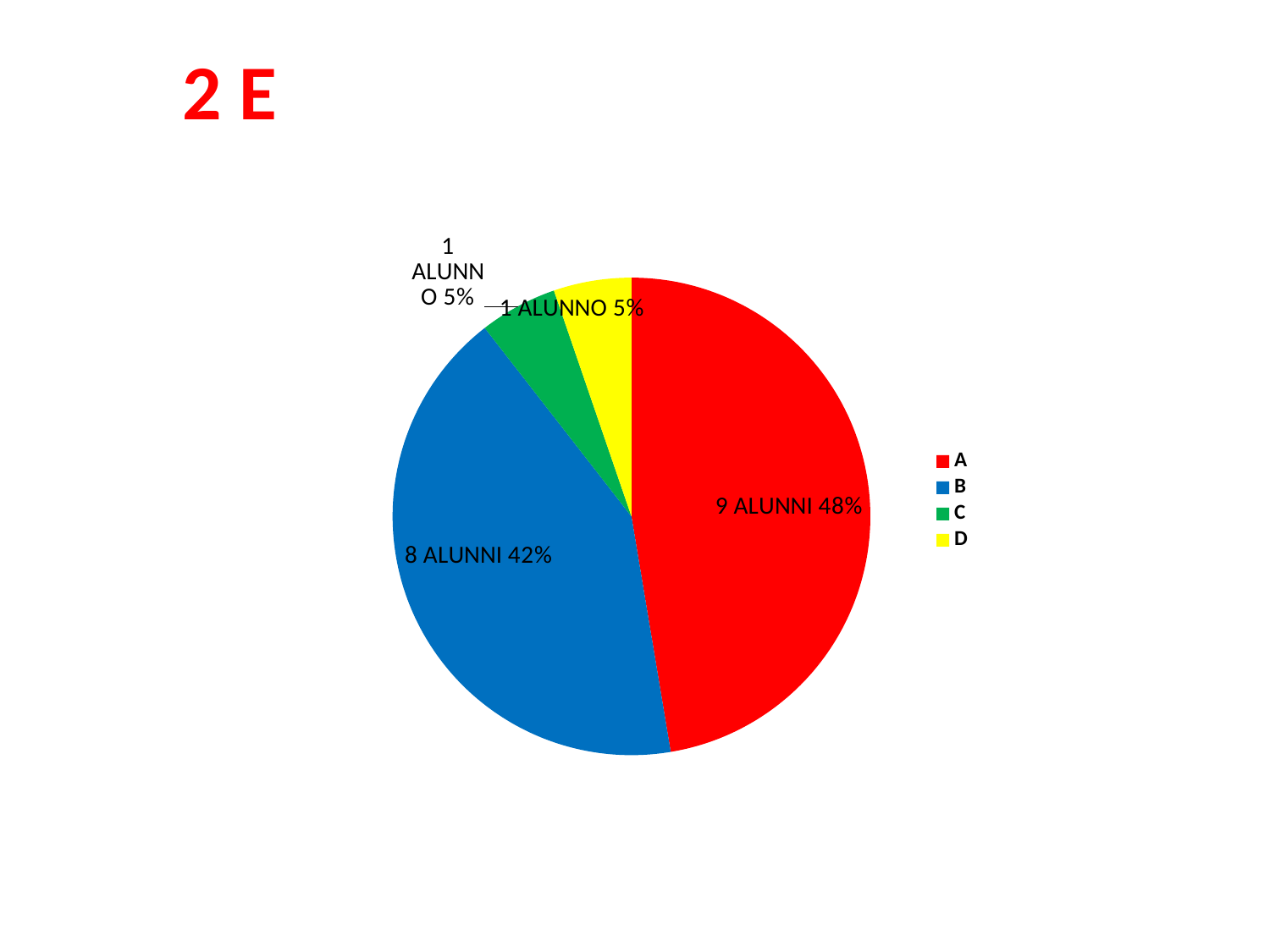
How many alunni are in category A? 9 ALUNNI What percentage share does category A have? 48% How many alunni are in category B? 8 ALUNNI What is the difference in percentage points between category A and category B? 6% What kind of chart is shown on the slide? pie chart What percentage share does category D (yellow) have? 5% How many categories does the legend list? 4 Which category has the largest slice of the pie? A What colour represents category B in the legend? blue What is the title shown on the slide? 2 E What percentage share does category B have? 42% Which category is larger, A or B? A